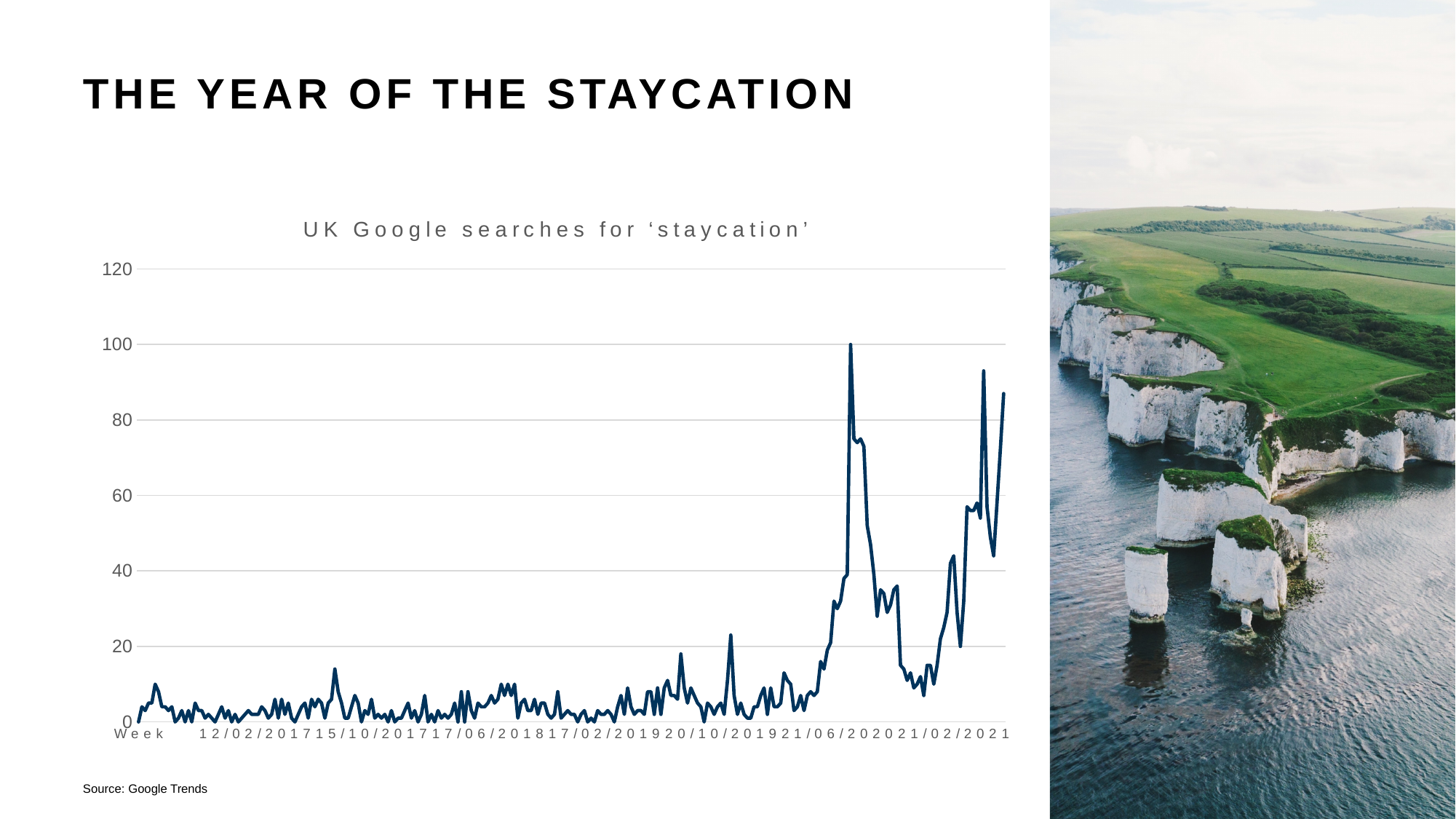
Which is larger: the value of the line around 21/06/2020 or the value around 15/10/2017? 21/06/2020 What kind of chart is shown on the slide? line chart Is the value of the line at 12/02/2017 greater or less than 20? less Overall, do the values rise or fall from the left of the x axis to the right? rise Is the final value of the line at the right end of the chart greater or less than 60? greater Is the value of the line at 17/06/2018 greater or less than 20? less What is the maximum value shown on the y axis? 120 What is the highest value reached by the line, as read against the y-axis gridline it touches? 100 What is the source cited for the chart? Google Trends What is the title of the chart? UK Google searches for 'staycation'